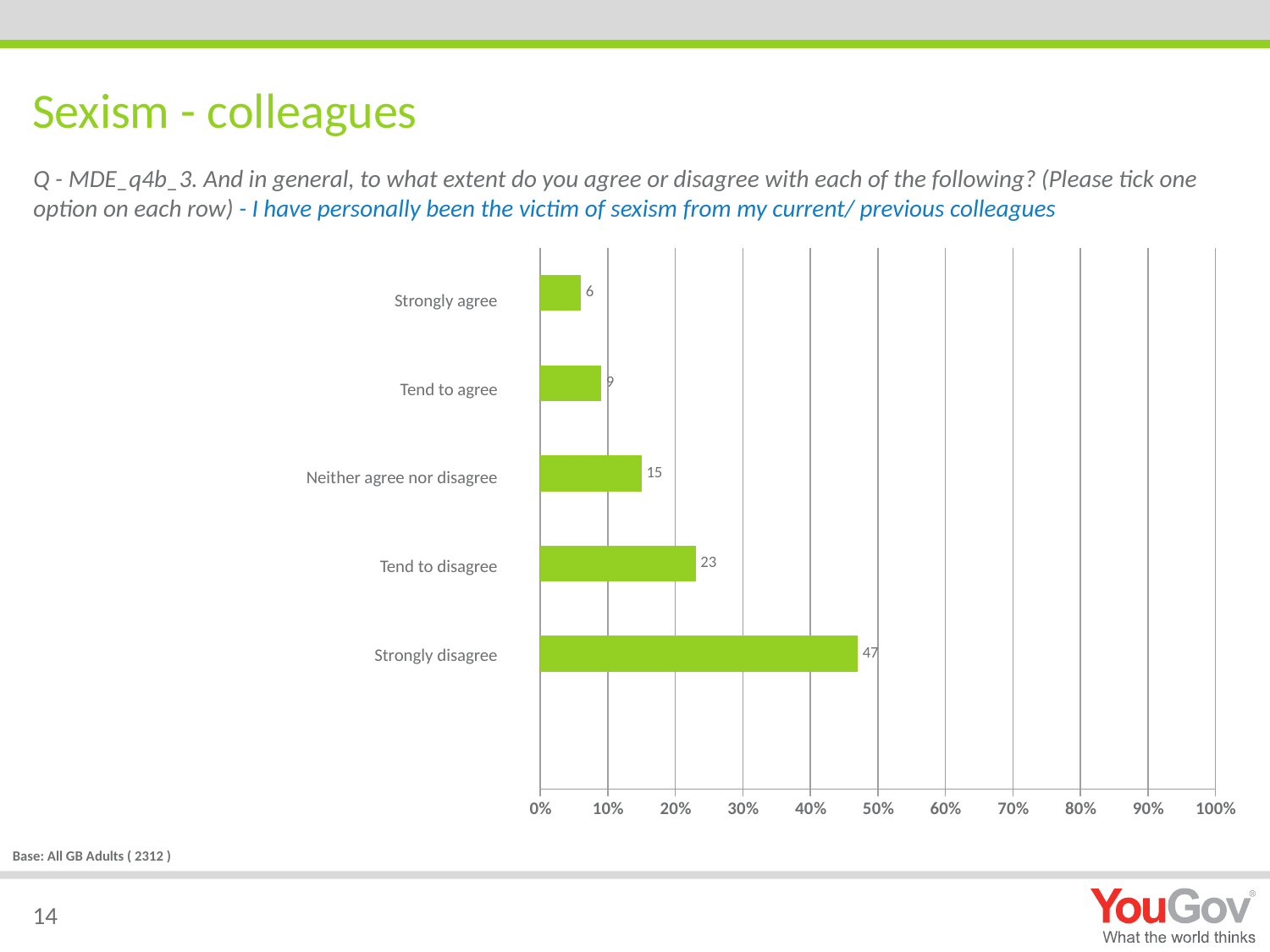
Which category has the lowest value? Strongly agree How many categories are shown in the chart? 5 What is the value for Strongly agree? 6 Which is larger, the value for Tend to agree or the value for Neither agree nor disagree? Neither agree nor disagree What is the value for Tend to disagree? 23 What is the difference between the values for Strongly disagree and Tend to disagree? 24 What is the value for Strongly disagree? 47 What is the value for Neither agree nor disagree? 15 Is the value for Strongly disagree greater or less than 40%? greater What is the title of the slide? Sexism - colleagues Which category has the highest value? Strongly disagree What kind of chart is shown on the slide? Bar chart